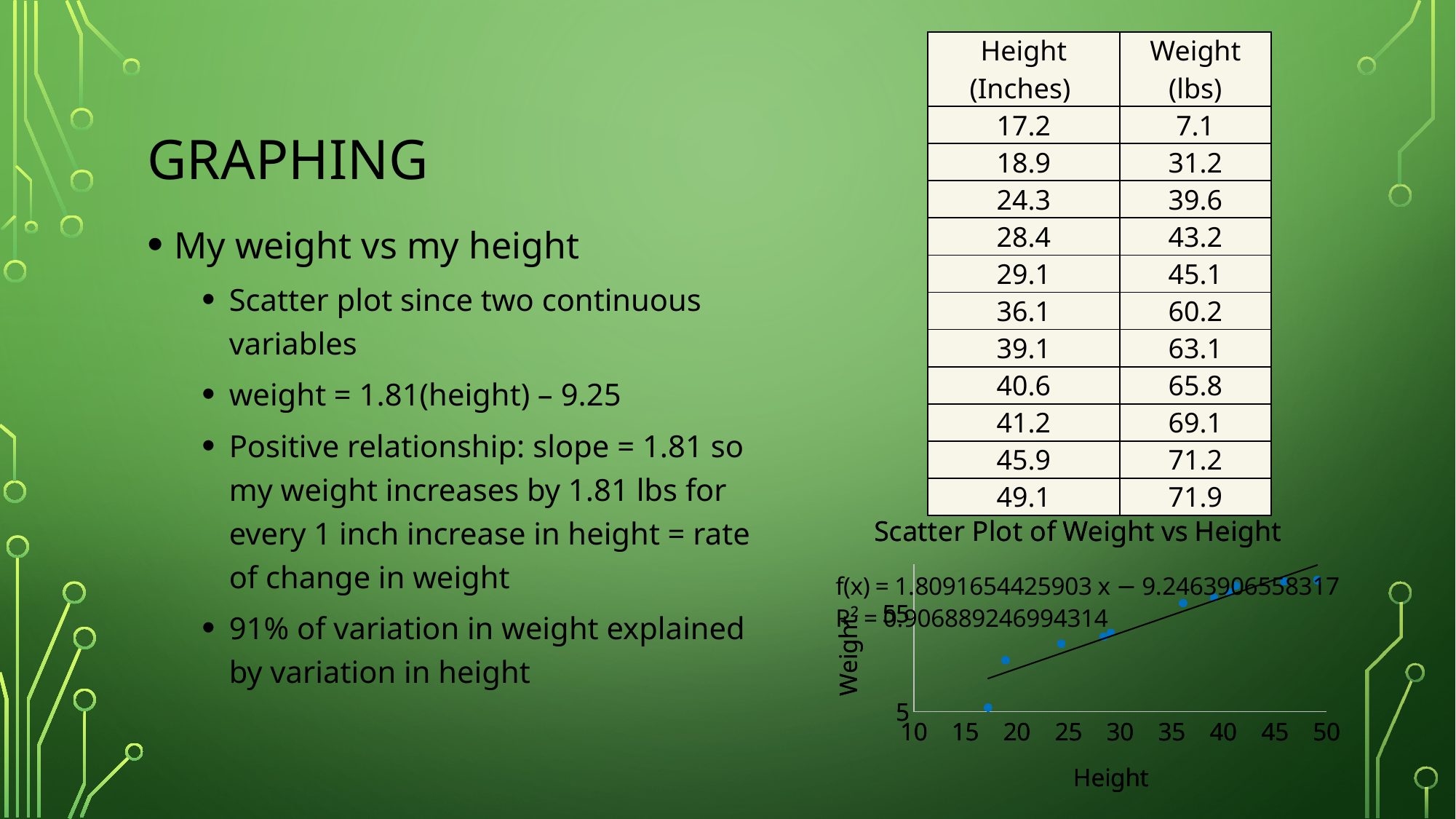
What is the highest weight value in the plotted data? 71.9 Which has the larger weight: the point at height 24.3 or the point at height 28.4? 28.4 Do the weight values rise or fall as height increases along the x axis? Rise Is the weight for the point at height 17.2 greater or less than 55? less What is the label on the x axis of the chart? Height What is the difference between the highest and lowest weight values in the data? 64.8 Is the weight for the point at height 49.1 greater or less than 55? greater What is the title of the chart? Scatter Plot of Weight vs Height What is the lowest weight value in the plotted data? 7.1 What kind of chart is shown on the slide? Scatter plot According to the data table, what is the weight (lbs) at a height of 36.1 inches? 60.2 How many data points are plotted in the scatter plot? 11